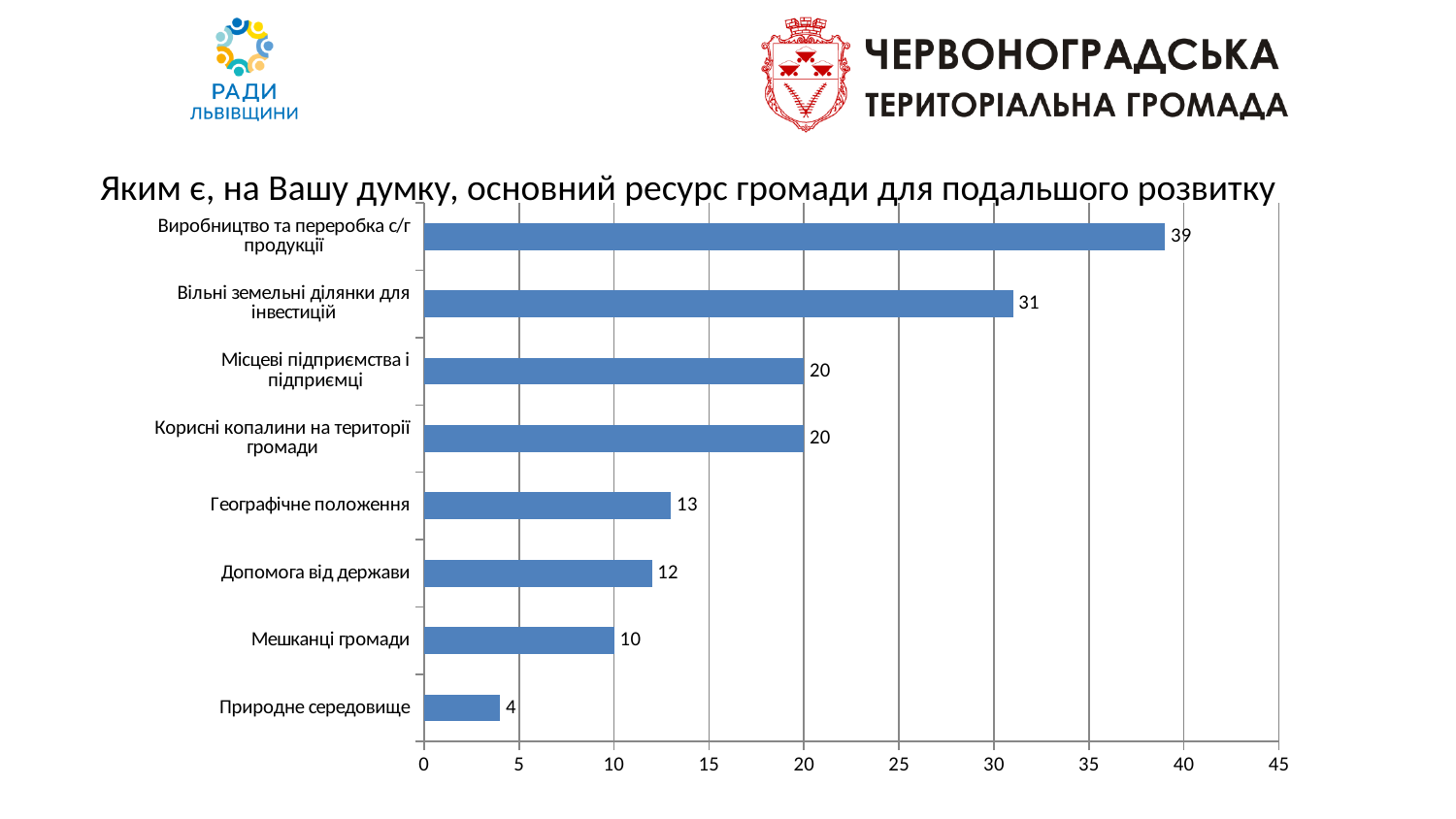
What is the value for "Виробництво та переробка с/г продукції"? 39 Is the value for "Місцеві підприємства і підприємці" greater or less than 15? greater What is the value for "Географічне положення"? 13 How many categories are shown in the chart? 8 What kind of chart is shown on the slide? bar chart What is the value for "Природне середовище"? 4 Which is larger: the value for "Допомога від держави" or the value for "Мешканці громади"? Допомога від держави What is the title of the chart? Яким є, на Вашу думку, основний ресурс громади для подальшого розвитку What is the value for "Вільні земельні ділянки для інвестицій"? 31 Which category has the highest value? Виробництво та переробка с/г продукції Which category has the lowest value? Природне середовище What is the difference between the values for "Виробництво та переробка с/г продукції" and "Вільні земельні ділянки для інвестицій"? 8